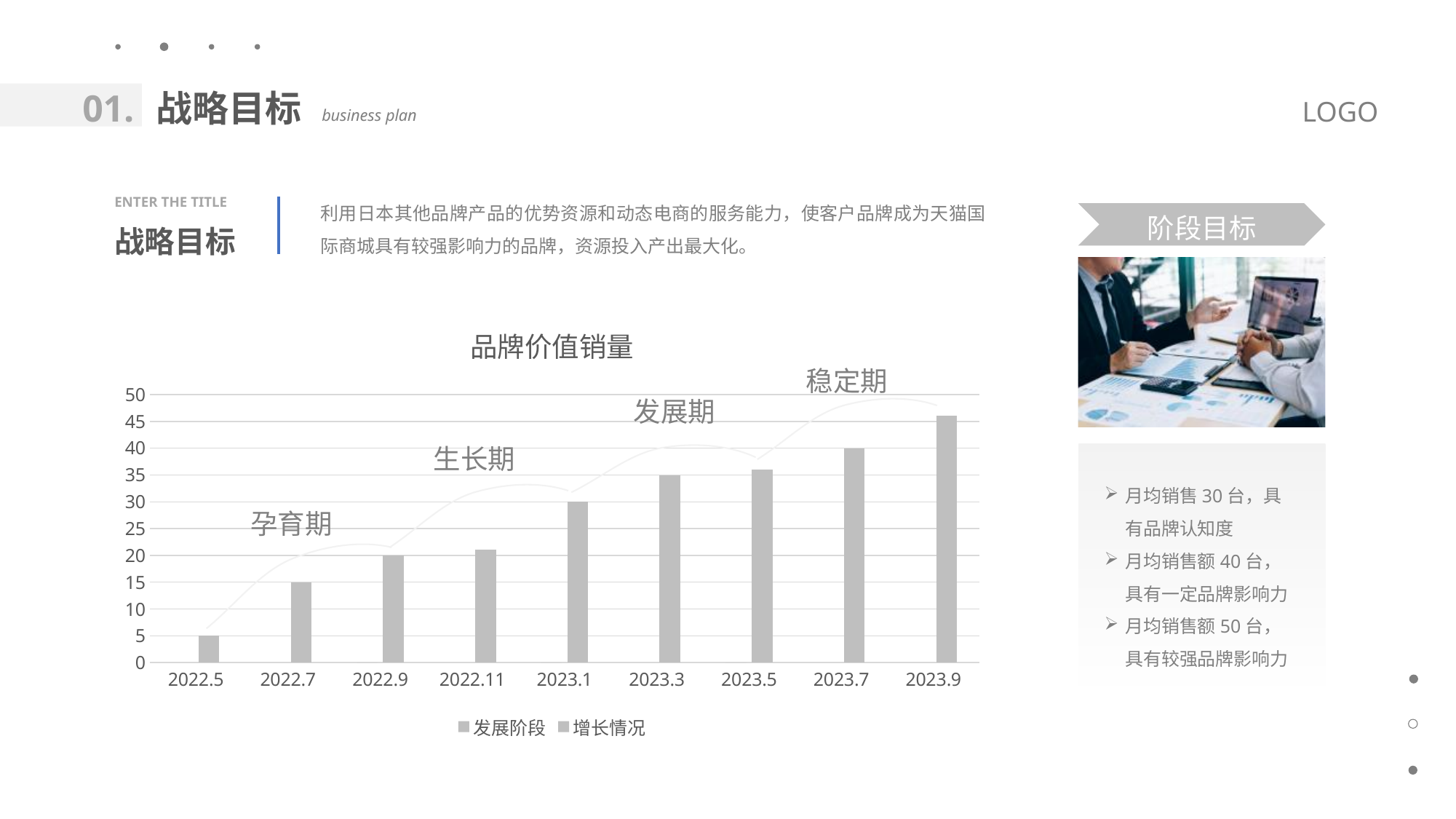
What is the title of the chart? 品牌价值销量 What is the value of the bar for 2022.7? 15 Do the bar values rise or fall from 2022.5 to 2023.9? rise What is the difference between the bar values for 2023.7 and 2022.7? 25 Which category has the lowest bar in the chart? 2022.5 What is the value of the bar for 2023.1? 30 How many series does the chart legend list? 2 How many categories are shown on the x axis of the chart? 9 Is the value for 2023.9 greater or less than 45? greater What kind of chart is shown on the slide? bar chart Which category has the highest bar in the chart? 2023.9 Is the value for 2022.11 greater or less than 25? less